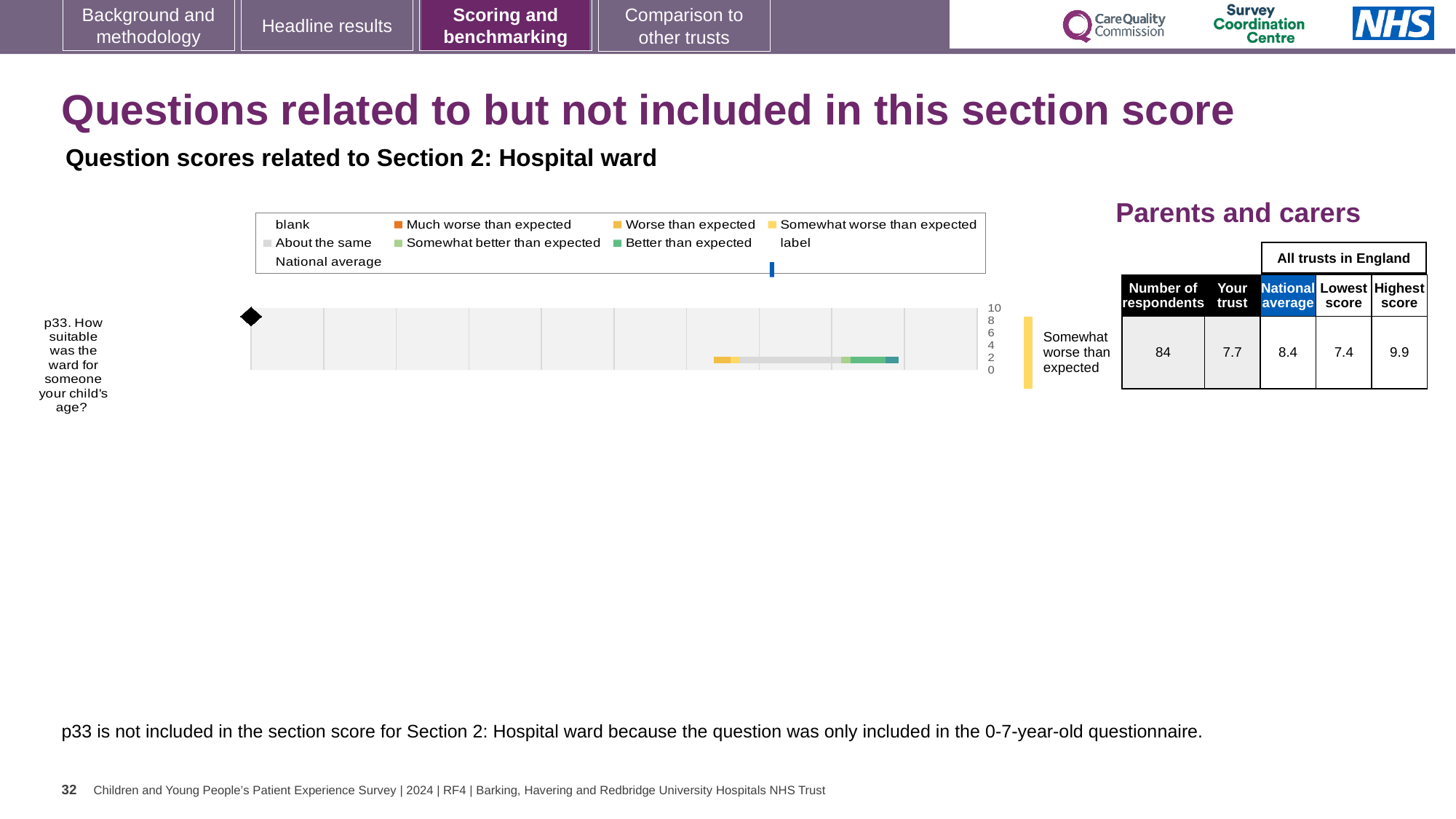
Which is larger for p33, the trust's score or the national average? National average What benchmark category is shown for the trust on p33? Somewhat worse than expected How many respondents answered p33? 84 What is the difference between the highest and lowest scores for p33? 2.5 How many questions are plotted in the chart? 1 Which question is plotted in the chart? p33. How suitable was the ward for someone your child's age? What is the lowest score among all trusts in England for p33? 7.4 What is the national average score for p33? 8.4 What is the highest score among all trusts in England for p33? 9.9 What kind of chart is used to show the p33 question score? Bar chart What is the 'Your trust' score for p33? 7.7 What is the difference between the national average and the trust's score for p33? 0.7